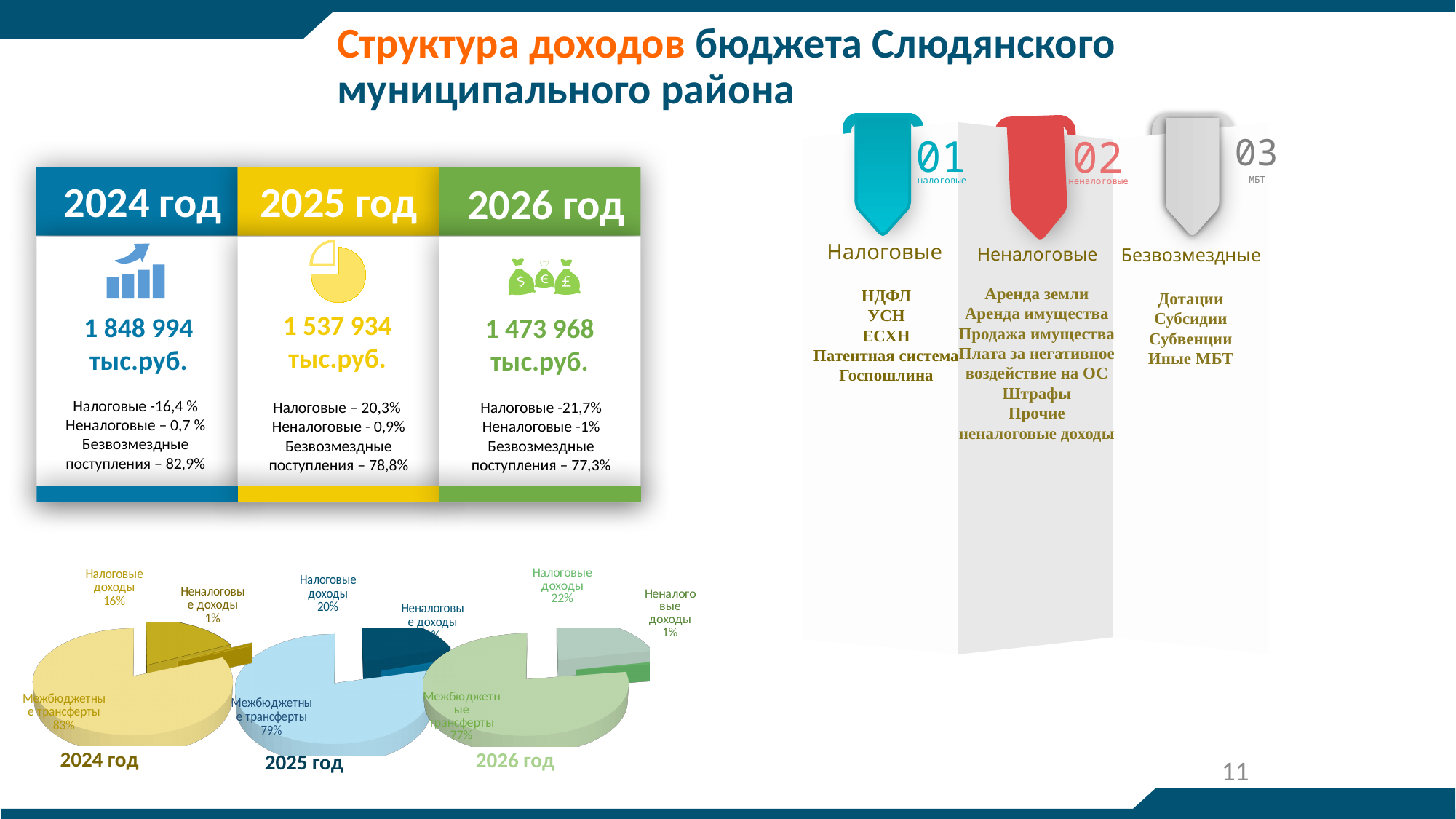
Which is larger: the Налоговые доходы share in the 2025 год pie chart or in the 2026 год pie chart? 2026 год In the 2024 год pie chart, what share is labelled for Межбюджетные трансферты? 83% In the 2026 год pie chart, what share is labelled for Налоговые доходы? 22% What is the difference between the Межбюджетные трансферты share in the 2024 год pie chart and in the 2026 год pie chart? 6 percentage points What type of chart is used for the 2025 год chart at the bottom of the slide? Pie chart How many slices does the 2024 год pie chart have? 3 In the 2026 год pie chart, which slice is the largest? Межбюджетные трансферты In the 2024 год pie chart, what share is labelled for Налоговые доходы? 16% In the 2025 год pie chart, what share is labelled for Налоговые доходы? 20% In the 2024 год pie chart, which slice is the smallest? Неналоговые доходы In the 2025 год pie chart, what share is labelled for Межбюджетные трансферты? 79% In the 2026 год pie chart, what share is labelled for Неналоговые доходы? 1%